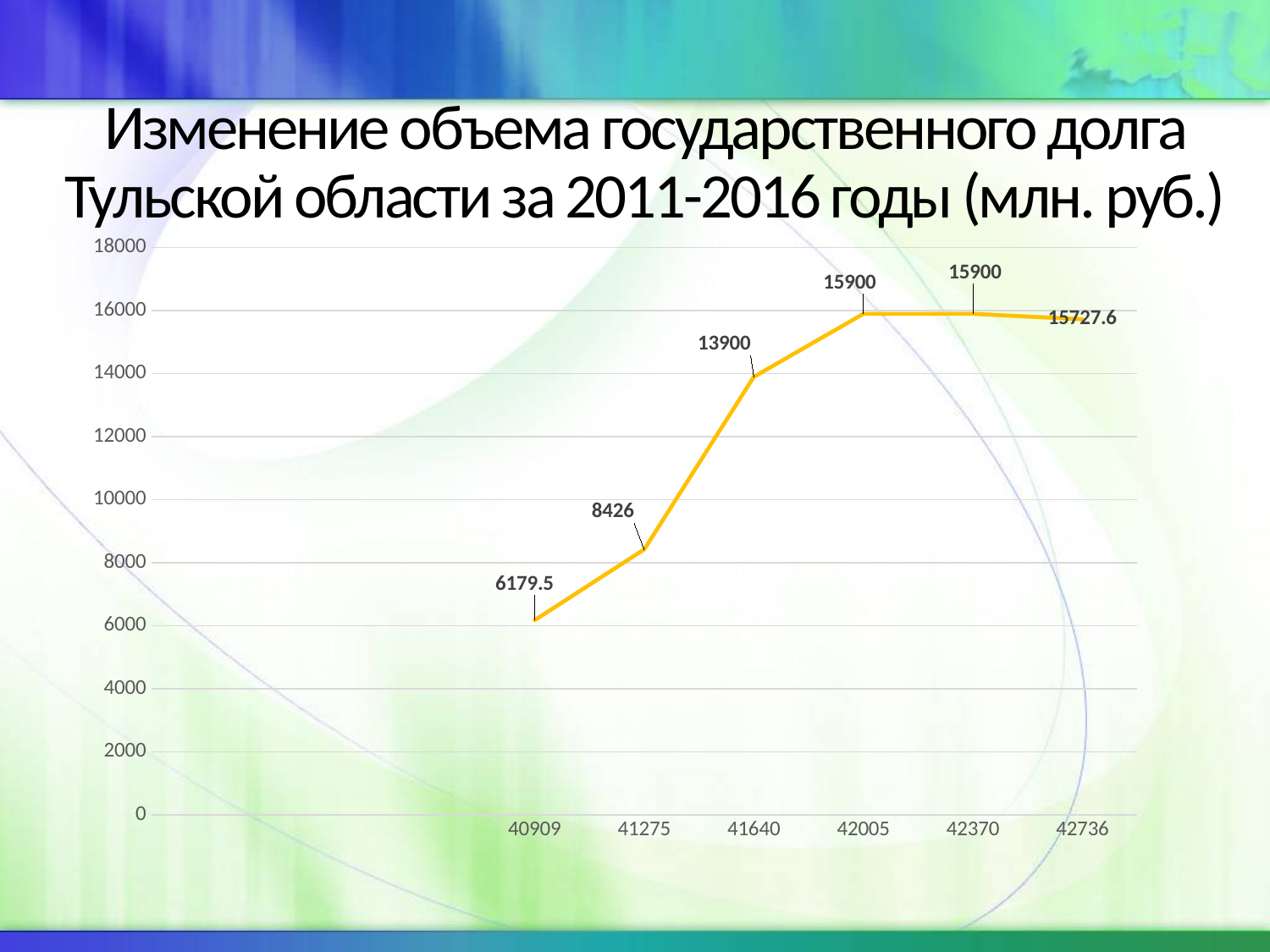
What is the value at the last point, labelled 42736? 15727.6 How many data points are plotted on the line? 6 What is the value at the point labelled 41640? 13900 What type of chart is shown on the slide? line chart What is the value at the point labelled 40909? 6179.5 Is the value at 41640 greater or less than 12000? greater Which x-axis point has the lowest value? 40909 What is the difference between the values at 42370 and 42736? 172.4 What is the value at the point labelled 41275? 8426 Which is larger, the value at 41275 or the value at 41640? 41640 What is the difference between the values at 41640 and 41275? 5474 What is the title of the chart? Изменение объема государственного долга Тульской области за 2011-2016 годы (млн. руб.)